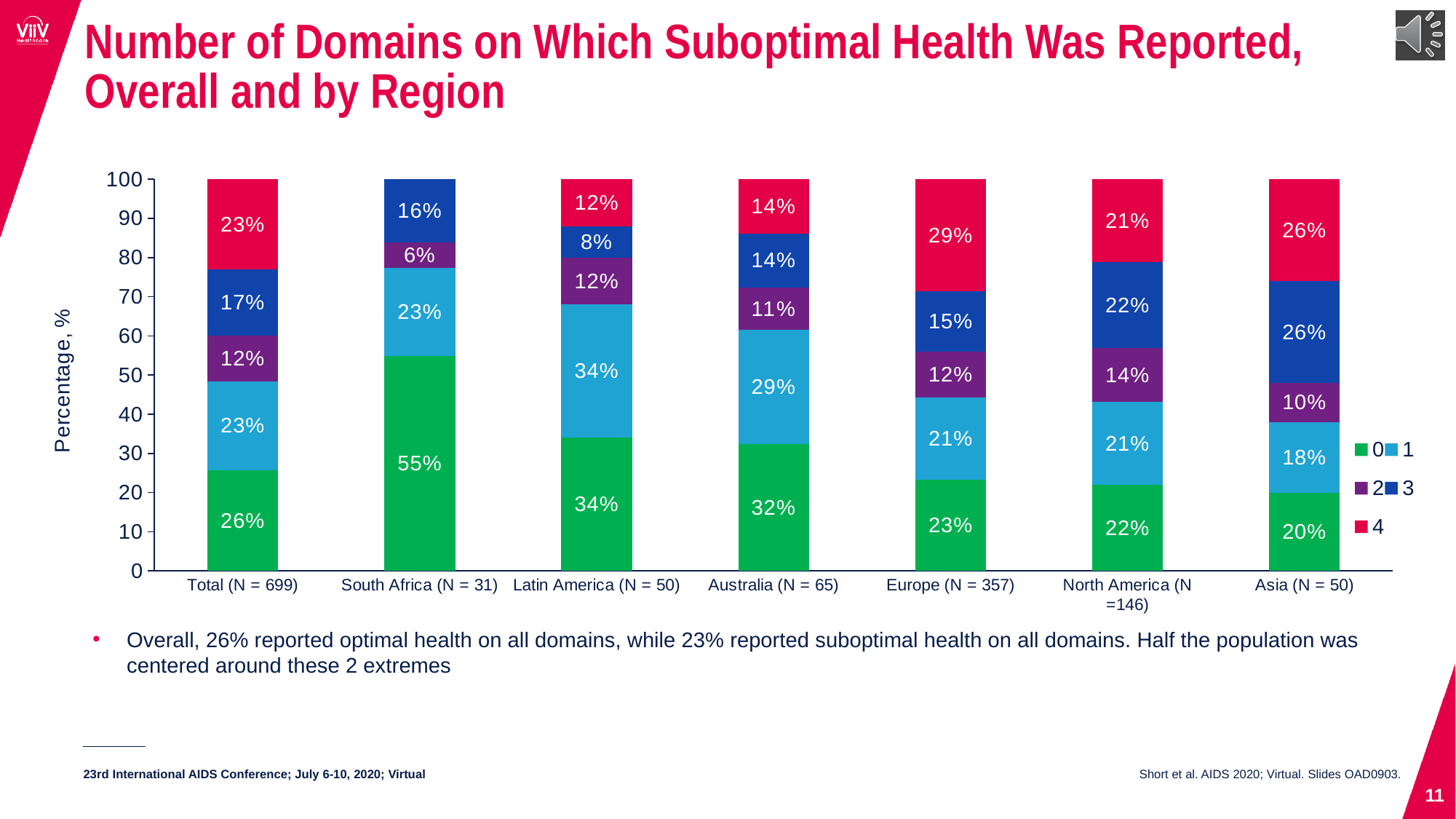
Which region has the highest percentage in the '0' series? South Africa (N = 31) What is the value of the '3' series for Asia (N = 50)? 26% What is the difference between the '0' value for South Africa (N = 31) and the '0' value for Total (N = 699)? 29% How many categories (regions including Total) are shown on the x axis? 7 What kind of chart is shown on the slide? Stacked bar chart What is the value of the '4' series for Europe (N = 357)? 29% What percentage of the Total (N = 699) group reported suboptimal health on 0 domains? 26% Which is larger: the '4' value for Europe (N = 357) or the '4' value for Latin America (N = 50)? Europe (N = 357) What is the label of the y axis? Percentage, % What percentage of South Africa (N = 31) reported suboptimal health on 1 domain? 23% Which region has the lowest percentage in the '0' series? Asia (N = 50) How many series does the legend list? 5